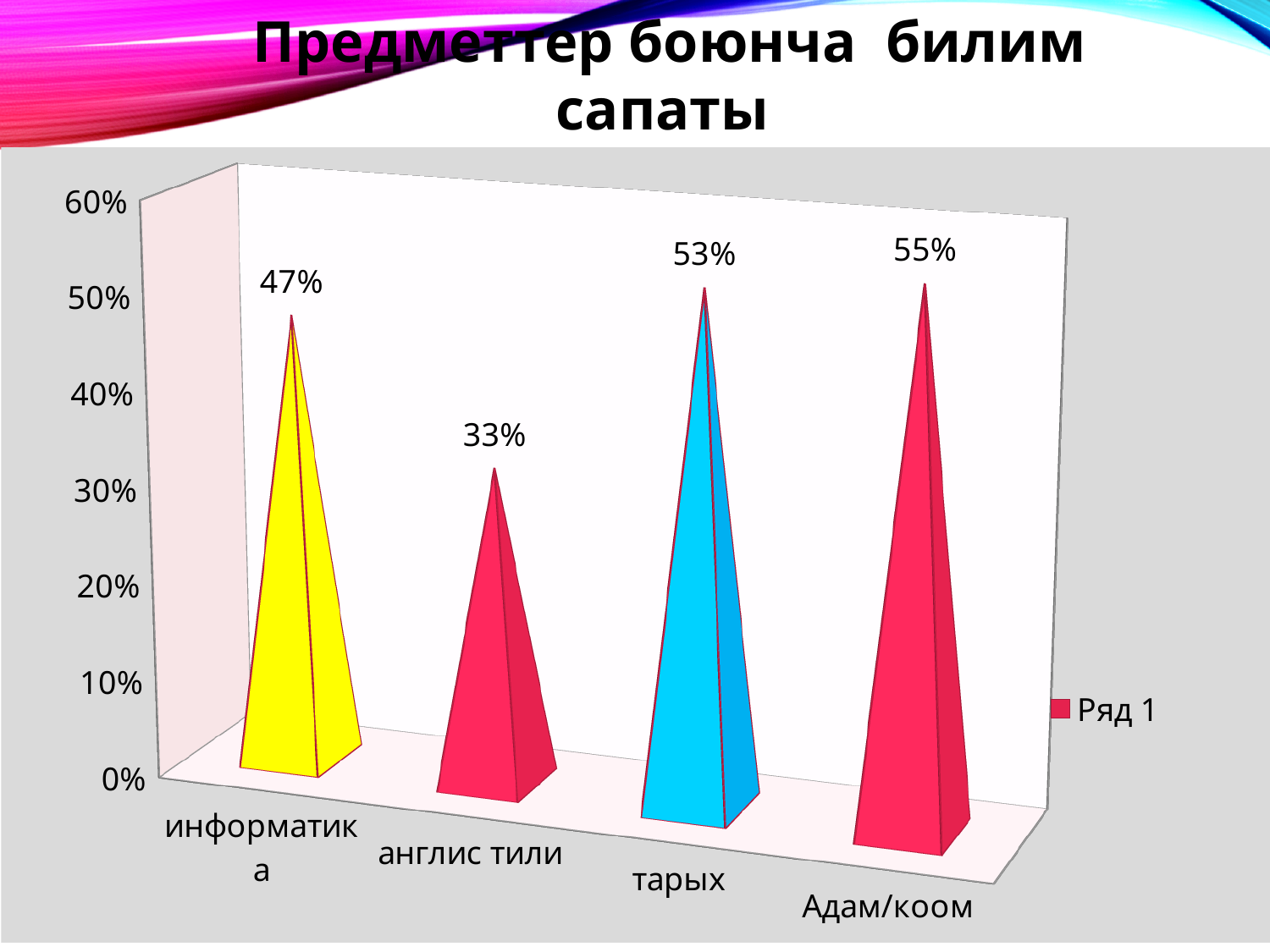
What is the value for тарых? 53% What is the legend entry shown on the chart? Ряд 1 Which is larger, the value for информатика or the value for тарых? тарых What is the value for Адам/коом? 55% What is the value for информатика? 47% What kind of chart is shown on the slide? bar chart Which category has the lowest value? англис тили How many categories are shown on the x axis? 4 What is the value for англис тили? 33% What is the difference between the values for Адам/коом and англис тили? 22% Which category has the highest value? Адам/коом Is the value for англис тили greater or less than 40%? less